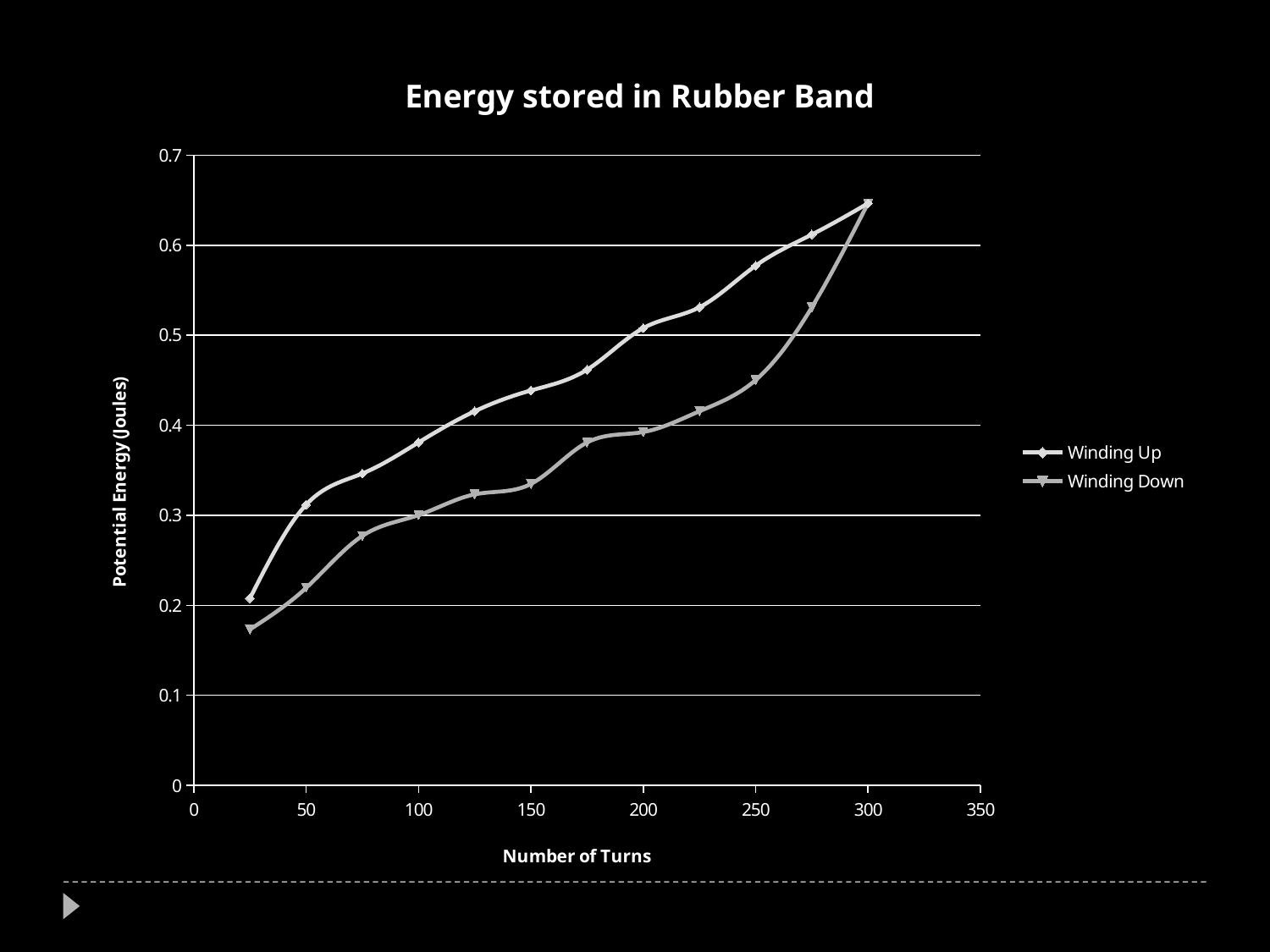
Is the Winding Down value at 25 turns greater or less than 0.2? less How many series does the legend list? 2 At 200 turns, which series has the higher potential energy, Winding Up or Winding Down? Winding Up Is the Winding Up value at 25 turns greater or less than 0.3? less What kind of chart is shown on the slide? Line chart Is the Winding Up value at 250 turns greater or less than 0.5? greater Do the Winding Up values rise or fall as the number of turns increases? Rise How many data points are plotted for the Winding Up series? 12 What is the label of the y axis? Potential Energy (Joules) What is the title of the chart? Energy stored in Rubber Band